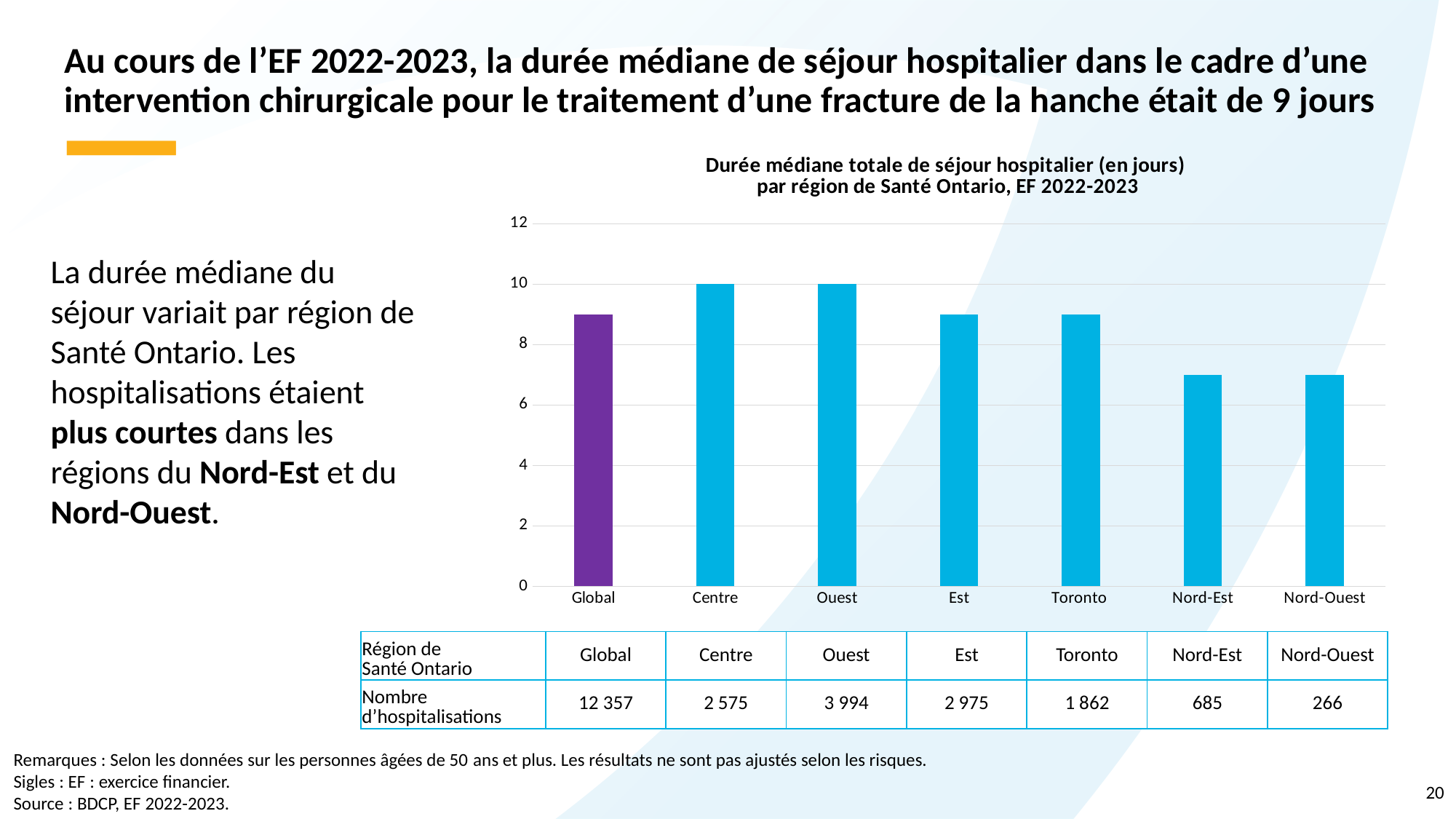
Is the value for Nord-Est greater or less than 8? less Is the value for Toronto greater or less than 8? greater How many regions (categories) are plotted in the chart? 7 Which has a longer median stay, Est or Nord-Ouest? Est What kind of chart is shown on the slide? bar chart Is the value for Nord-Ouest greater or less than 6? greater What is the title of the chart? Durée médiane totale de séjour hospitalier (en jours) par région de Santé Ontario, EF 2022-2023 Which has a longer median stay, Centre or Nord-Est? Centre What is the median total hospital stay in days for Ouest? 10 What is the median total hospital stay in days for Centre? 10 Which bar is shown in a different colour (purple) from the others? Global What is the median total hospital stay in days for Global? 9